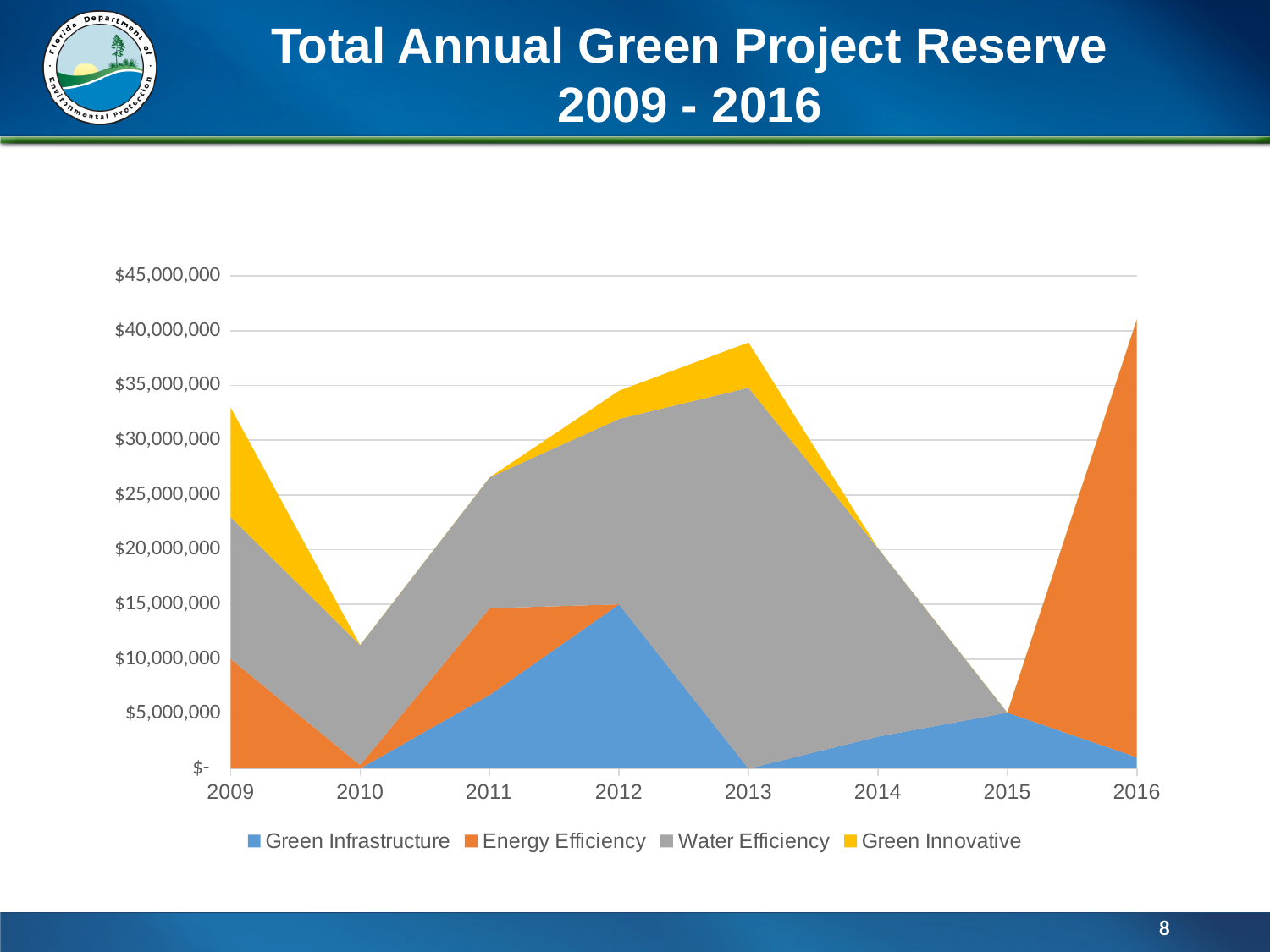
Is the total value for 2015 greater or less than $10,000,000? less How many years are shown along the x axis? 8 Is the total value for 2009 greater or less than $30,000,000? greater What kind of chart is shown on the slide? Stacked area chart Does the total Green Project Reserve rise or fall from 2013 to 2015? fall Does the total Green Project Reserve rise or fall from 2010 to 2013? rise Is the total value for 2013 greater or less than $35,000,000? greater Which year has the lowest total Green Project Reserve? 2015 How many series does the legend list? 4 Which series is shown in gray in the legend? Water Efficiency Which year has the highest total Green Project Reserve? 2016